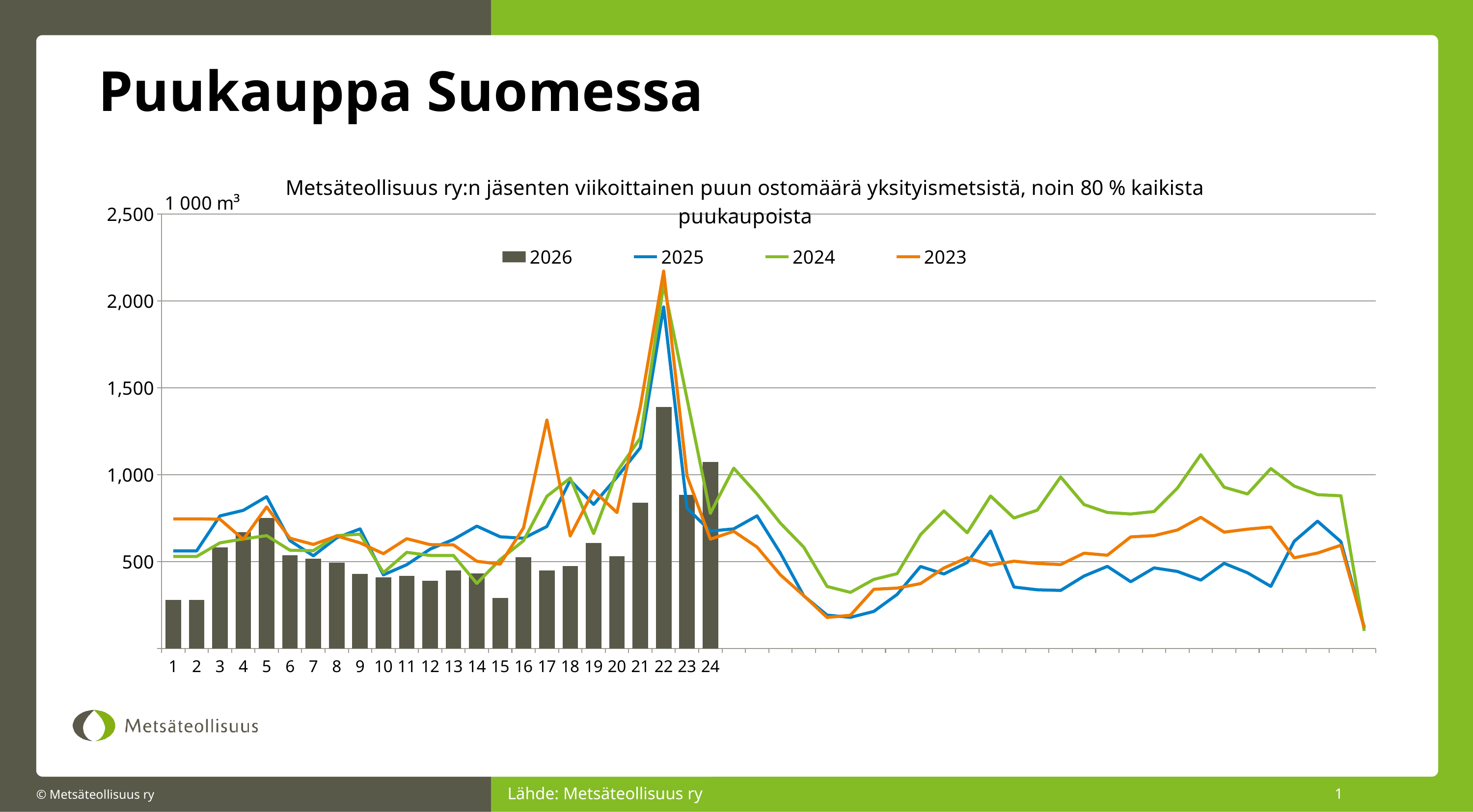
How many weeks have a bar plotted for the 2026 series? 24 In which week is the 2026 bar the highest? 22 Is the 2026 value for week 22 greater or less than 1,000? greater Is the 2026 value for week 1 greater or less than 500? less Is the 2023 value for week 22 greater or less than 2,000? greater At week 17, which is higher: the 2023 line or the 2025 line? 2023 Do the 2026 bars rise or fall from week 19 to week 22? rise What kind of chart is shown on the slide? A combined bar and line chart Which series in the legend is drawn as bars rather than a line? 2026 At week 22, which is higher: the 2023 line or the 2026 bar? 2023 How many series does the chart legend list? 4 What unit is shown on the vertical axis of the chart? 1 000 m³